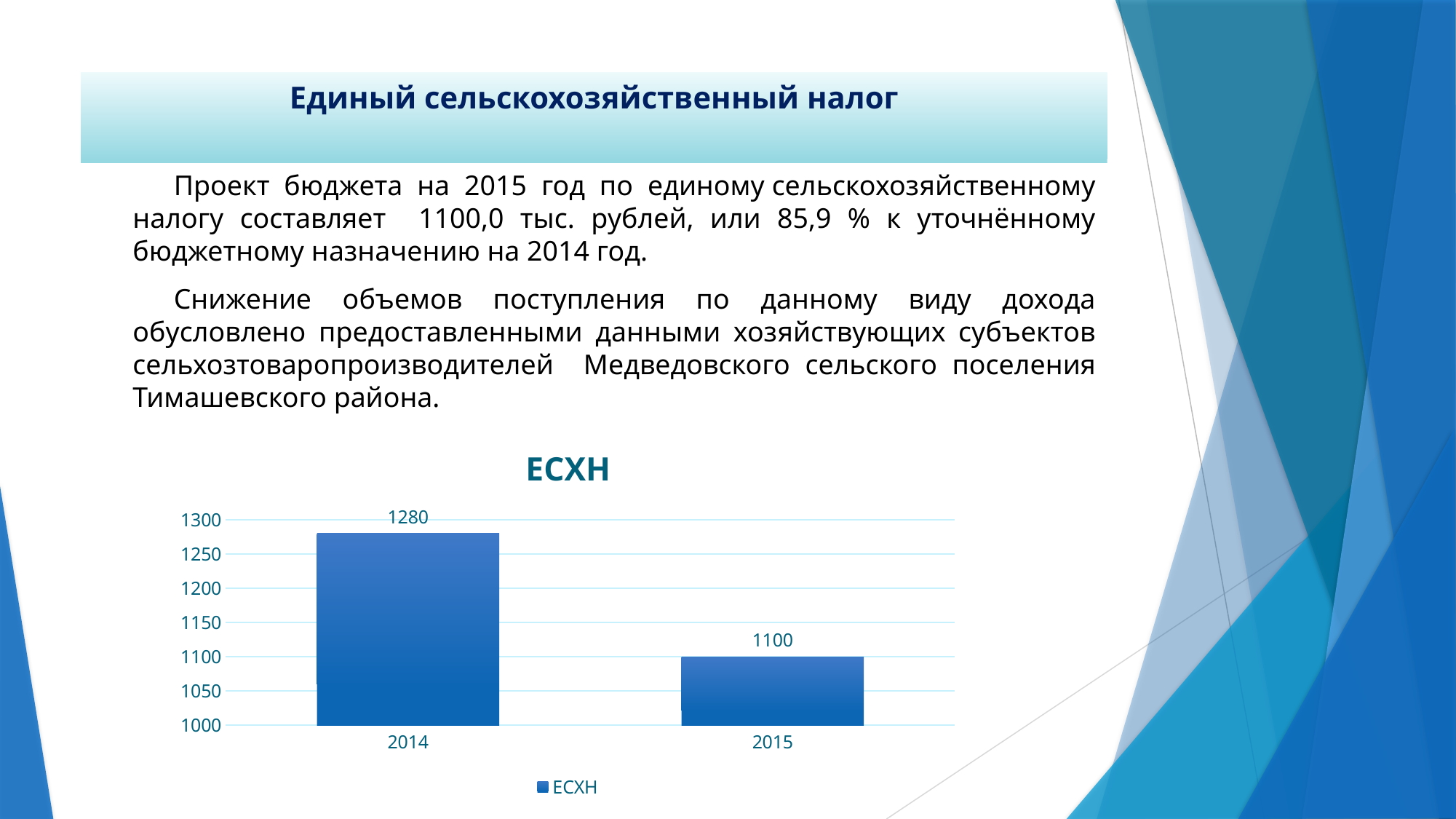
What is the difference between the 2014 and 2015 values in the ЕСХН chart? 180 Which year has the highest value in the ЕСХН chart? 2014 How many categories are shown on the x axis of the ЕСХН chart? 2 Do the values in the ЕСХН chart rise or fall from 2014 to 2015? fall What is the value for 2014 in the ЕСХН chart? 1280 Which is larger in the ЕСХН chart, the value for 2014 or for 2015? 2014 What is the value for 2015 in the ЕСХН chart? 1100 How many series does the legend of the ЕСХН chart list? 1 Which year has the lowest value in the ЕСХН chart? 2015 Is the value for 2014 in the ЕСХН chart greater or less than 1250? greater Is the value for 2015 in the ЕСХН chart greater or less than 1150? less What kind of chart is shown on the slide? bar chart